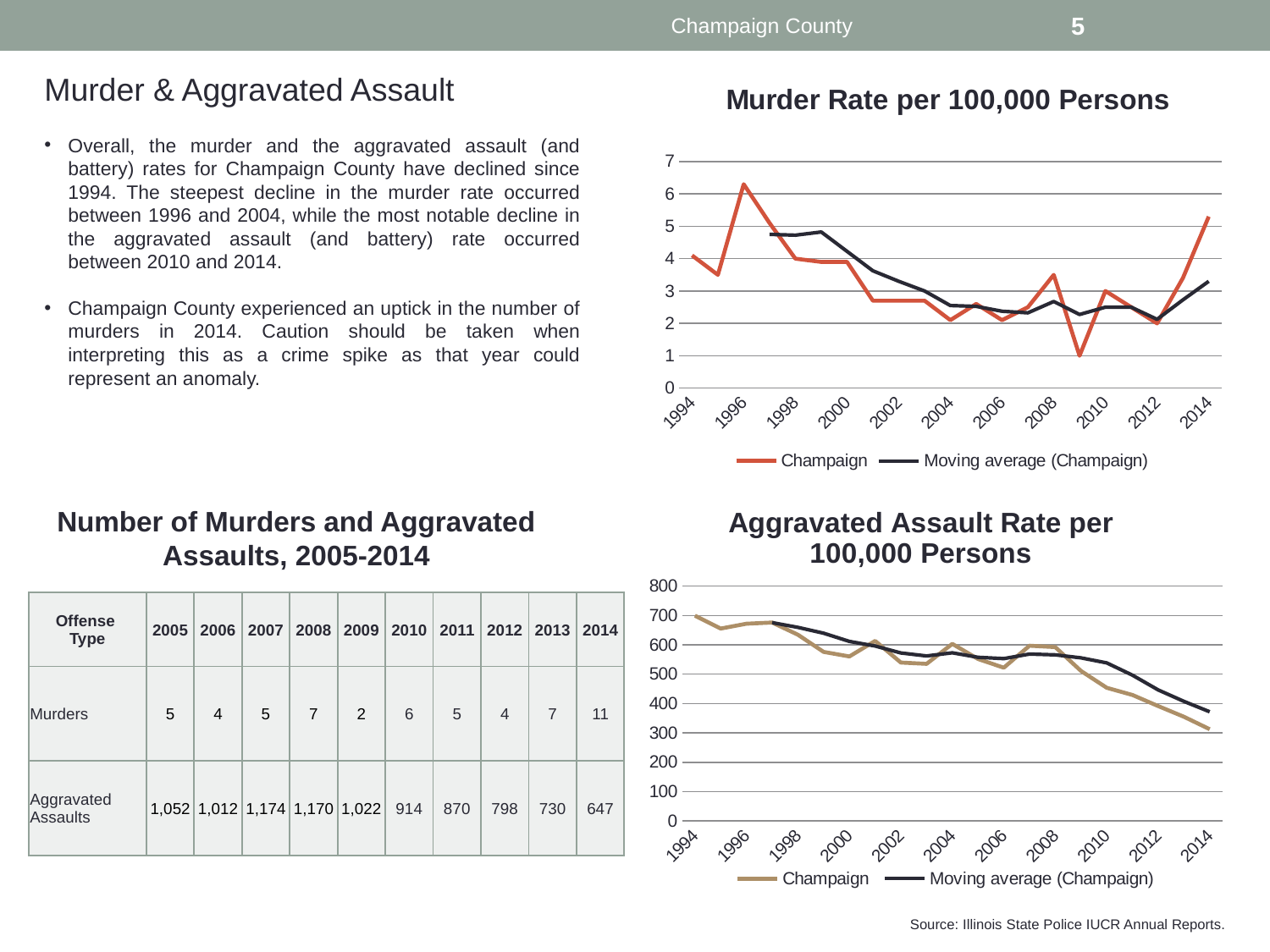
In the "Murder Rate per 100,000 Persons" chart, is the Champaign value for 1996 greater or less than 5? greater In the "Murder Rate per 100,000 Persons" chart, is the Champaign value for 2014 greater or less than 4? greater In the "Aggravated Assault Rate per 100,000 Persons" chart, which year has the lowest Champaign rate? 2014 In the "Murder Rate per 100,000 Persons" chart, which year has the lowest Champaign murder rate? 2009 In the "Aggravated Assault Rate per 100,000 Persons" chart, which year has the highest Champaign rate? 1994 In the "Murder Rate per 100,000 Persons" chart, is the Champaign value for 2009 greater or less than 2? less What kind of chart is the "Murder Rate per 100,000 Persons" chart? Line chart In the "Aggravated Assault Rate per 100,000 Persons" chart, do the Champaign values generally rise or fall from 1994 to 2014? Fall What are the two legend entries in the "Murder Rate per 100,000 Persons" chart? Champaign; Moving average (Champaign) In the "Murder Rate per 100,000 Persons" chart, which year has the highest Champaign murder rate? 1996 How many series does the legend of the "Aggravated Assault Rate per 100,000 Persons" chart list? 2